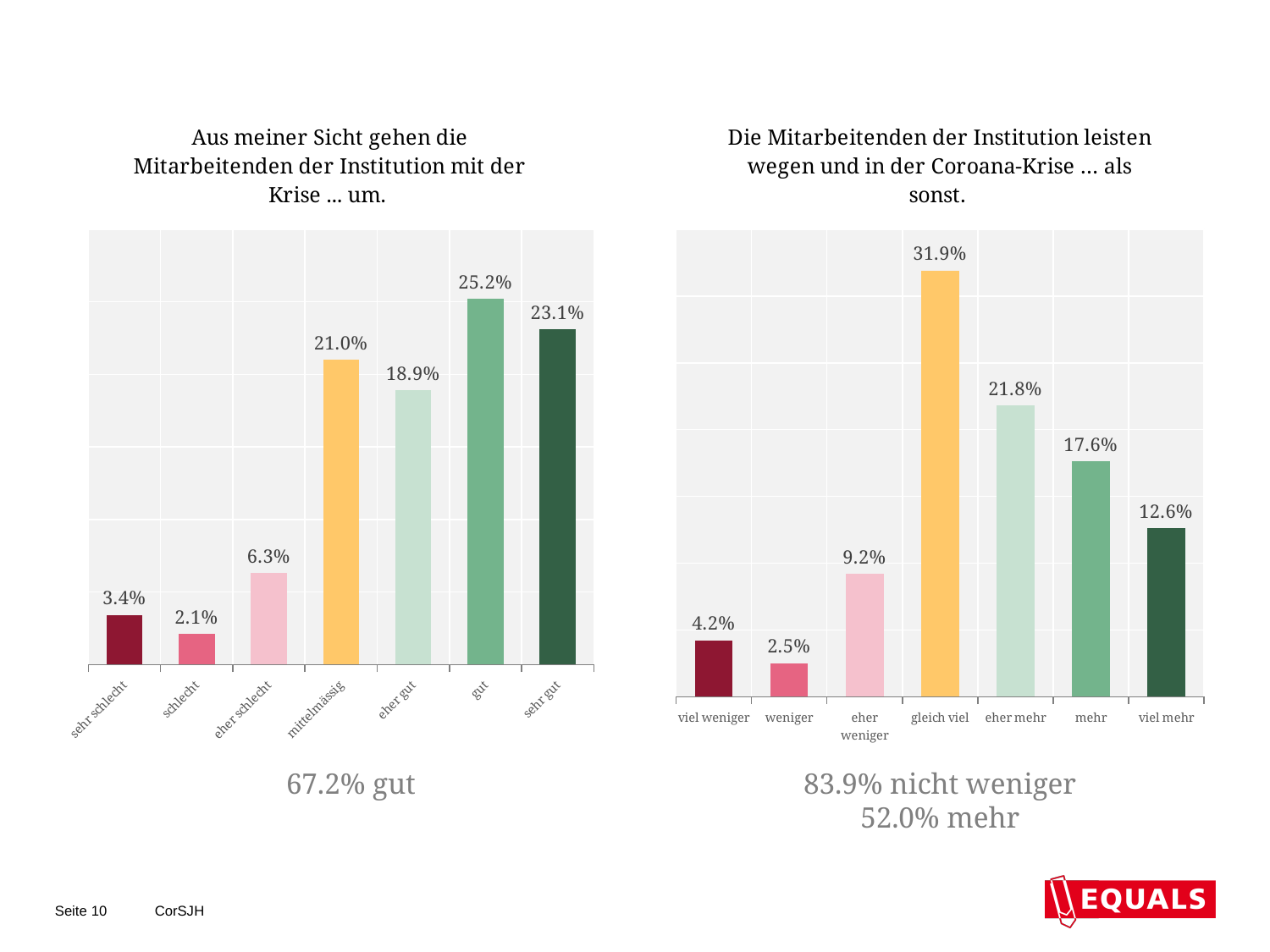
In the right chart, which is larger, "eher mehr" or "mehr"? eher mehr In the right chart, what is the difference between "gleich viel" and "eher mehr"? 10.1% In the right chart, what is the value for "viel mehr"? 12.6% In the right chart, which category has the lowest value? weniger What type of chart is the right chart? Bar chart In the left chart, which category has the lowest value? schlecht In the left chart, how many categories are shown on the x axis? 7 In the right chart ("Die Mitarbeitenden der Institution leisten wegen und in der Coroana-Krise ... als sonst."), what is the value for "gleich viel"? 31.9% In the left chart, which category has the highest value? gut In the left chart ("Aus meiner Sicht gehen die Mitarbeitenden der Institution mit der Krise ... um."), what is the value for "gut"? 25.2% In the left chart, what is the difference between "gut" and "sehr gut"? 2.1% In the left chart, what is the value for "eher schlecht"? 6.3%